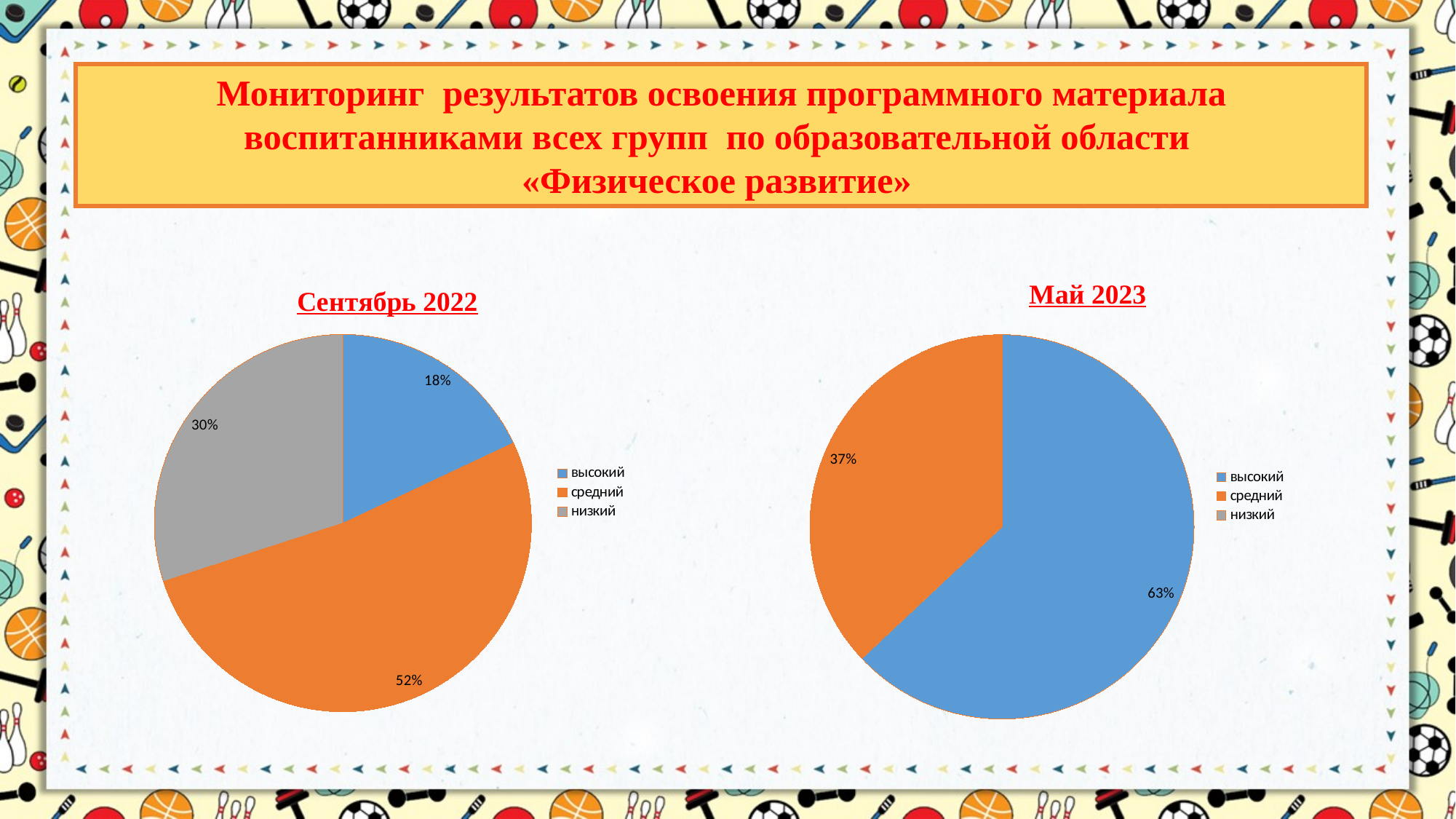
In the "Сентябрь 2022" chart, what is the value for "низкий"? 30% In the "Сентябрь 2022" chart, what is the value for "высокий"? 18% In the "Май 2023" chart, which is larger, "высокий" or "средний"? высокий In the "Май 2023" chart, what is the difference between "высокий" and "средний"? 26% In the "Сентябрь 2022" chart, which category has the largest share? средний In the "Сентябрь 2022" chart, which category has the smallest share? высокий In the "Май 2023" chart, what is the value for "высокий"? 63% In the "Май 2023" chart, what is the value for "средний"? 37% What kind of chart is the "Сентябрь 2022" chart? pie chart In the "Сентябрь 2022" chart, what is the difference between "средний" and "высокий"? 34% In the "Сентябрь 2022" chart, what is the value for "средний"? 52% How many entries does the legend of the "Май 2023" chart list? 3